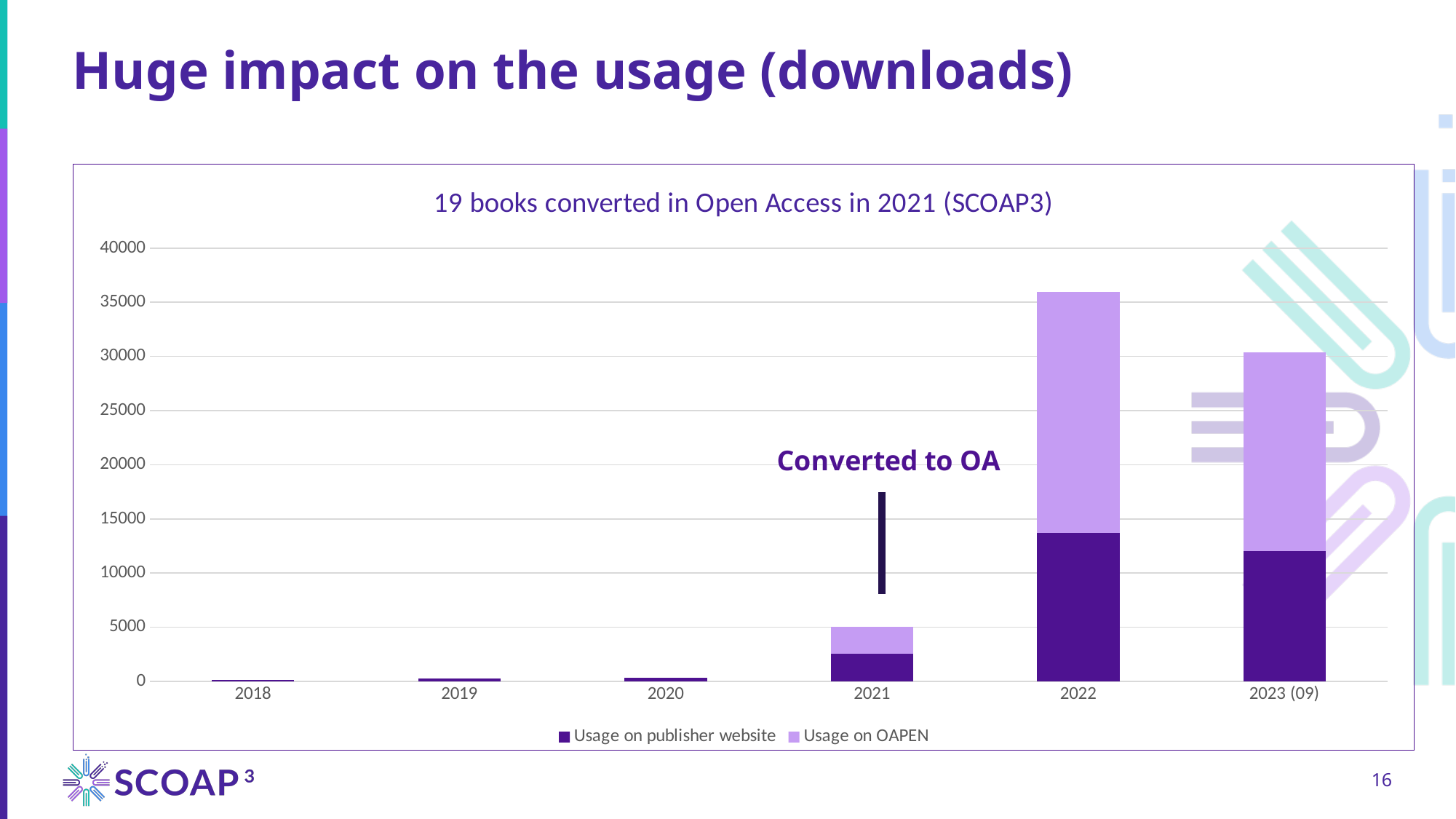
Which year has the larger total downloads, 2022 or 2023 (09)? 2022 How many year categories are shown on the x axis? 6 Which year has the highest total downloads? 2022 Which series is shown in the darker purple colour? Usage on publisher website Is the 'Usage on publisher website' value for 2022 greater or less than 10000? greater What is the title of the chart? 19 books converted in Open Access in 2021 (SCOAP3) What kind of chart is shown on the slide? Stacked bar chart Is the total value for 2023 (09) greater or less than 25000? greater Is the total value for 2022 greater or less than 30000? greater How many series does the legend list? 2 Which year has the lowest total downloads? 2018